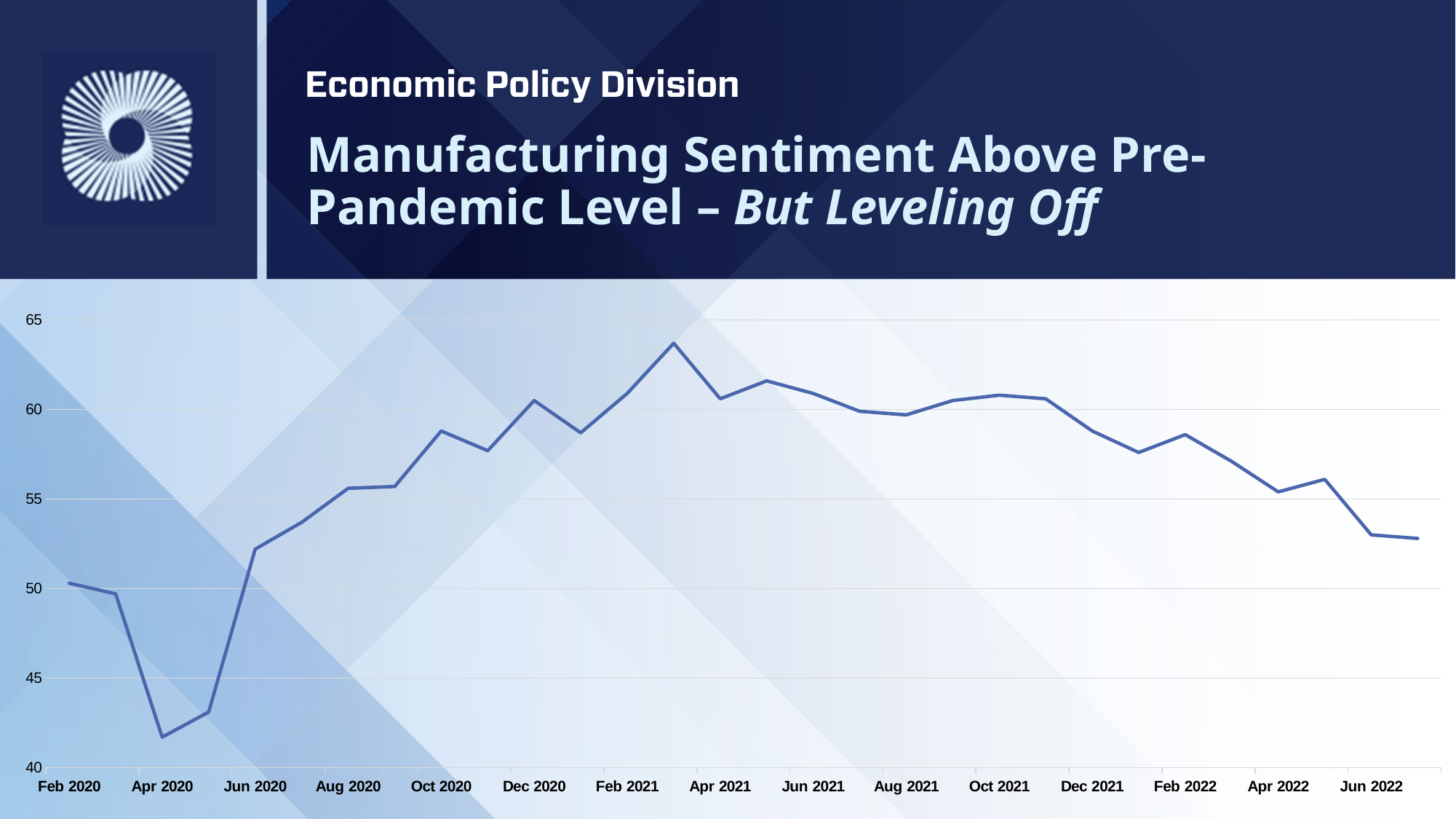
Is the value for Jun 2022 greater or less than 55? less Is the value for Jun 2020 greater or less than 50? greater Do the values generally rise or fall between Apr 2020 and Feb 2021? rise Which is larger, the value for Apr 2020 or the value for Jun 2020? Jun 2020 Is the value for Apr 2020 greater or less than 45? less Which labeled month on the x axis has the lowest value? Apr 2020 What kind of chart is shown on the slide? line chart Do the values generally rise or fall between Oct 2021 and Jun 2022? fall Which is larger, the value for Feb 2021 or the value for Jun 2022? Feb 2021 How many month labels are shown on the x axis? 15